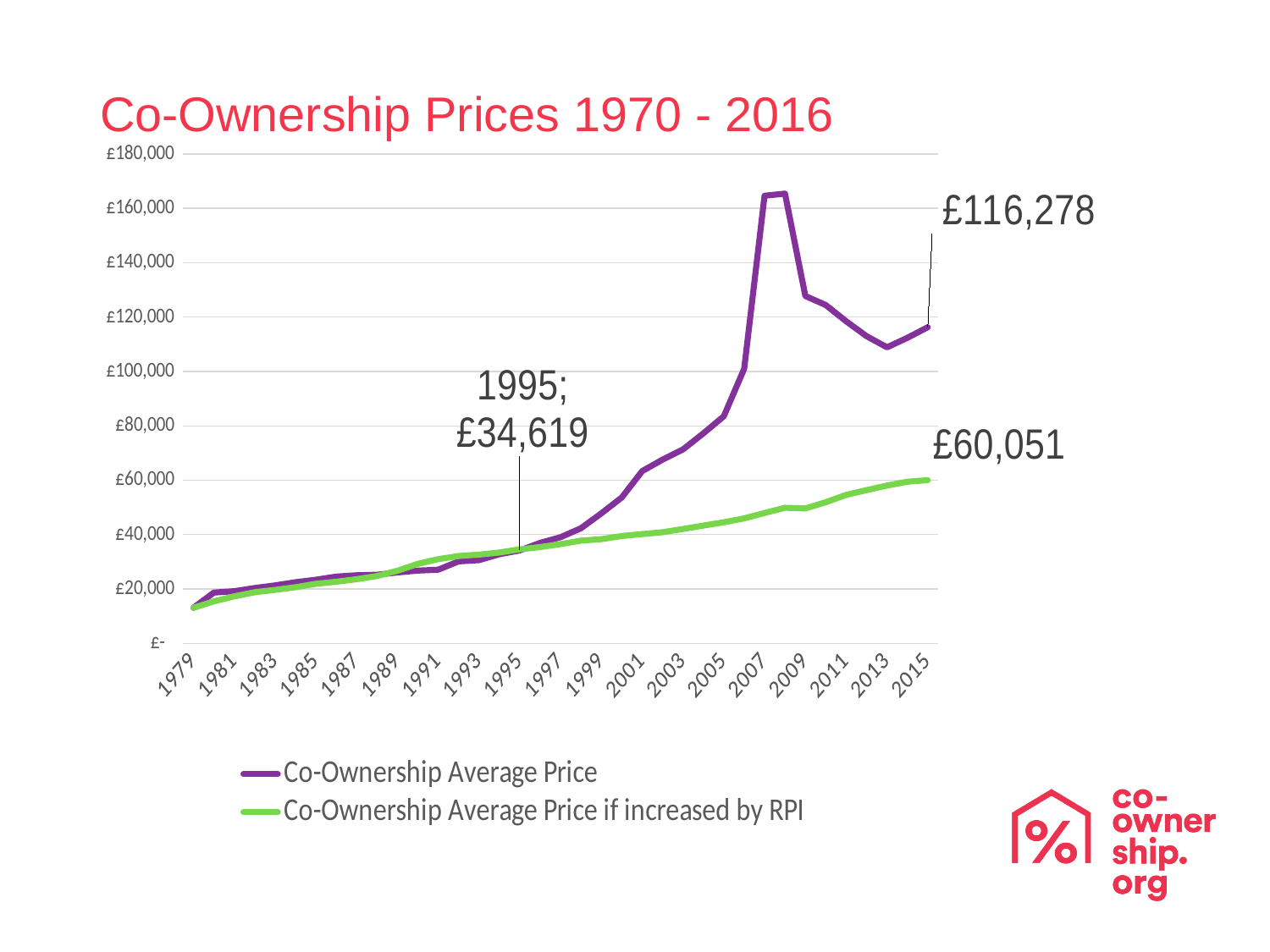
How many series does the legend list? 2 What is the final labelled value of the Co-Ownership Average Price if increased by RPI series? £60,051 What kind of chart is shown on the slide? Line chart Is the value of the Co-Ownership Average Price line in 2013 greater or less than £100,000? greater What is the difference between the two final labelled values, £116,278 and £60,051? £56,227 What is the final labelled value of the Co-Ownership Average Price series? £116,278 What value is labelled on the chart for 1995? £34,619 What is the title of the chart? Co-Ownership Prices 1970 - 2016 At the end of the chart, which series has the higher value: Co-Ownership Average Price or Co-Ownership Average Price if increased by RPI? Co-Ownership Average Price Is the value of the Co-Ownership Average Price if increased by RPI line in 2009 greater or less than £60,000? less Does the Co-Ownership Average Price if increased by RPI line generally rise or fall from 1979 to 2015? Rise Is the peak value of the Co-Ownership Average Price line greater or less than £160,000? greater